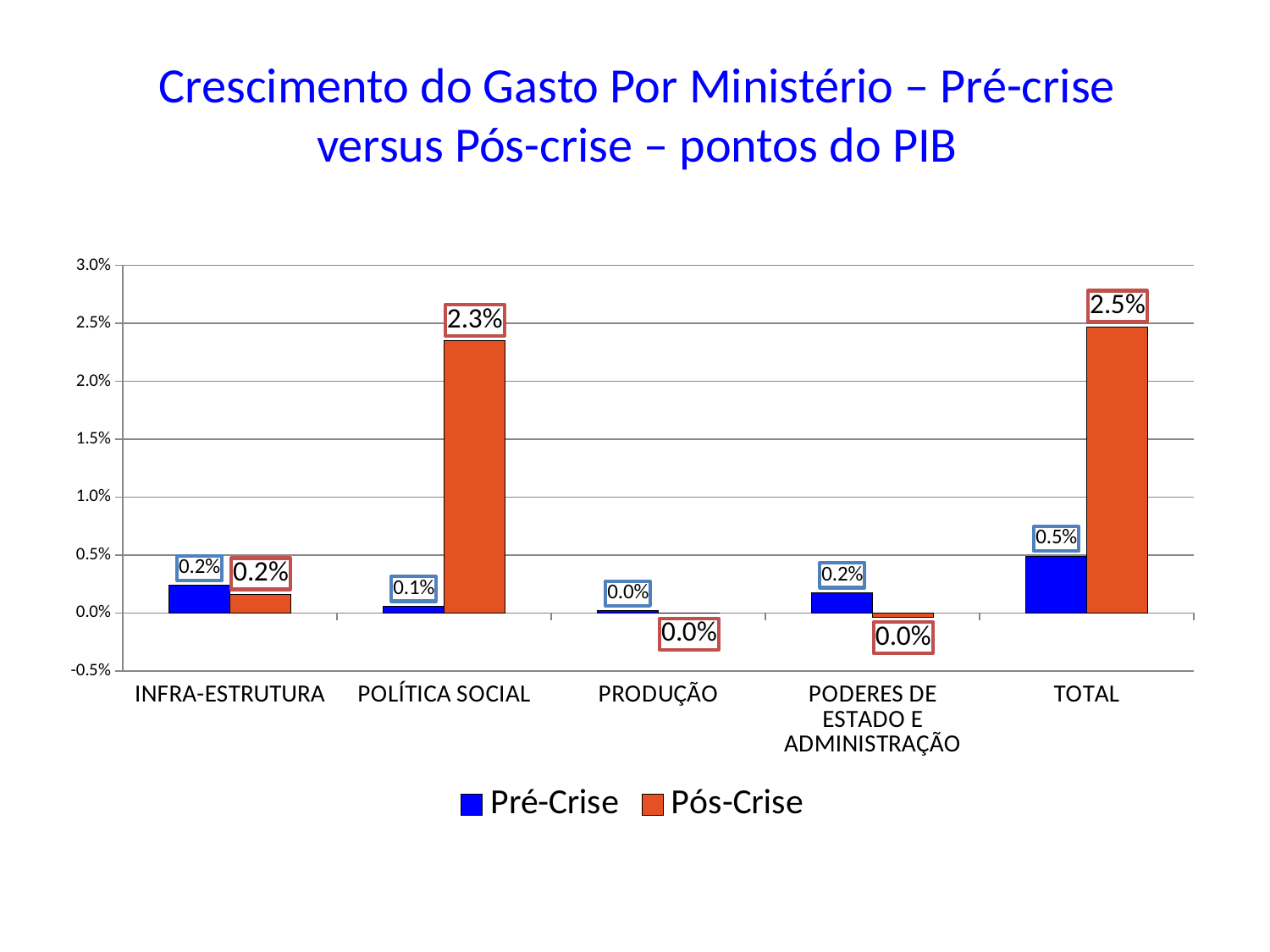
How many series does the legend list? 2 Which category has the lowest Pré-Crise value? PRODUÇÃO Is the Pós-Crise value for POLÍTICA SOCIAL greater or less than 2.0%? greater What is the difference between the Pós-Crise and Pré-Crise values for POLÍTICA SOCIAL? 2.2 percentage points Which category has the highest Pós-Crise value? TOTAL How many categories are shown on the x axis? 5 What kind of chart is shown on the slide? Bar chart Which is larger: the Pós-Crise value for POLÍTICA SOCIAL or the Pós-Crise value for TOTAL? TOTAL What is the Pré-Crise value for PODERES DE ESTADO E ADMINISTRAÇÃO? 0.2% What is the Pré-Crise value for TOTAL? 0.5% Which colour represents the Pós-Crise series in the legend? Orange What is the Pós-Crise value for POLÍTICA SOCIAL? 2.3%